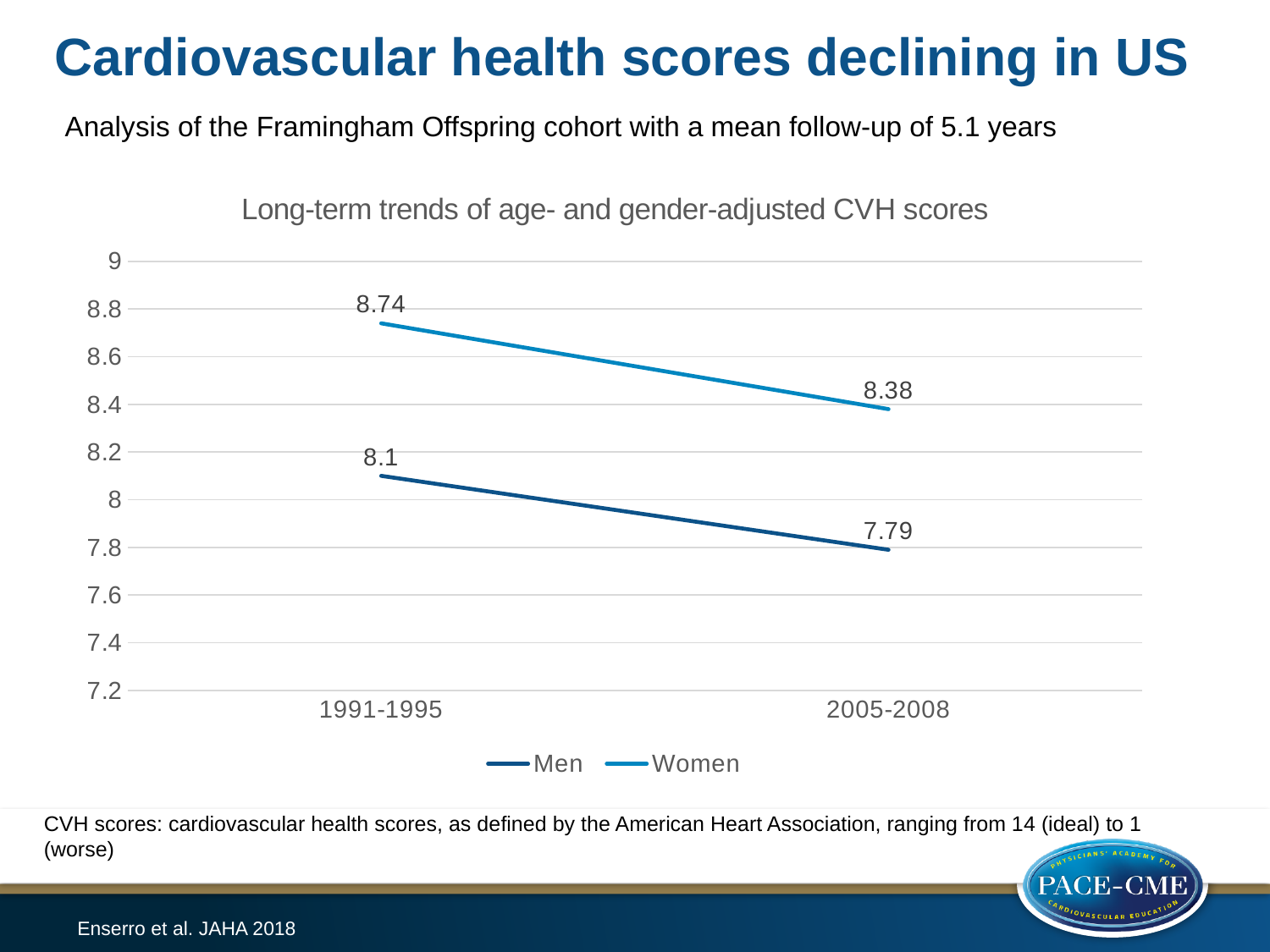
Is the Men's CVH score in 2005-2008 greater or less than 8? less What is the CVH score for Men in 1991-1995? 8.1 How many series does the legend list? 2 How many time periods are shown on the x axis? 2 Do the CVH scores for Men rise or fall from 1991-1995 to 2005-2008? Fall What is the difference between the Women's and Men's CVH scores in 1991-1995? 0.64 Which series has the higher CVH score in 2005-2008, Men or Women? Women What is the CVH score for Women in 2005-2008? 8.38 What is the CVH score for Women in 1991-1995? 8.74 By how much did the Women's CVH score decrease from 1991-1995 to 2005-2008? 0.36 What type of chart is shown on the slide? Line chart What is the CVH score for Men in 2005-2008? 7.79